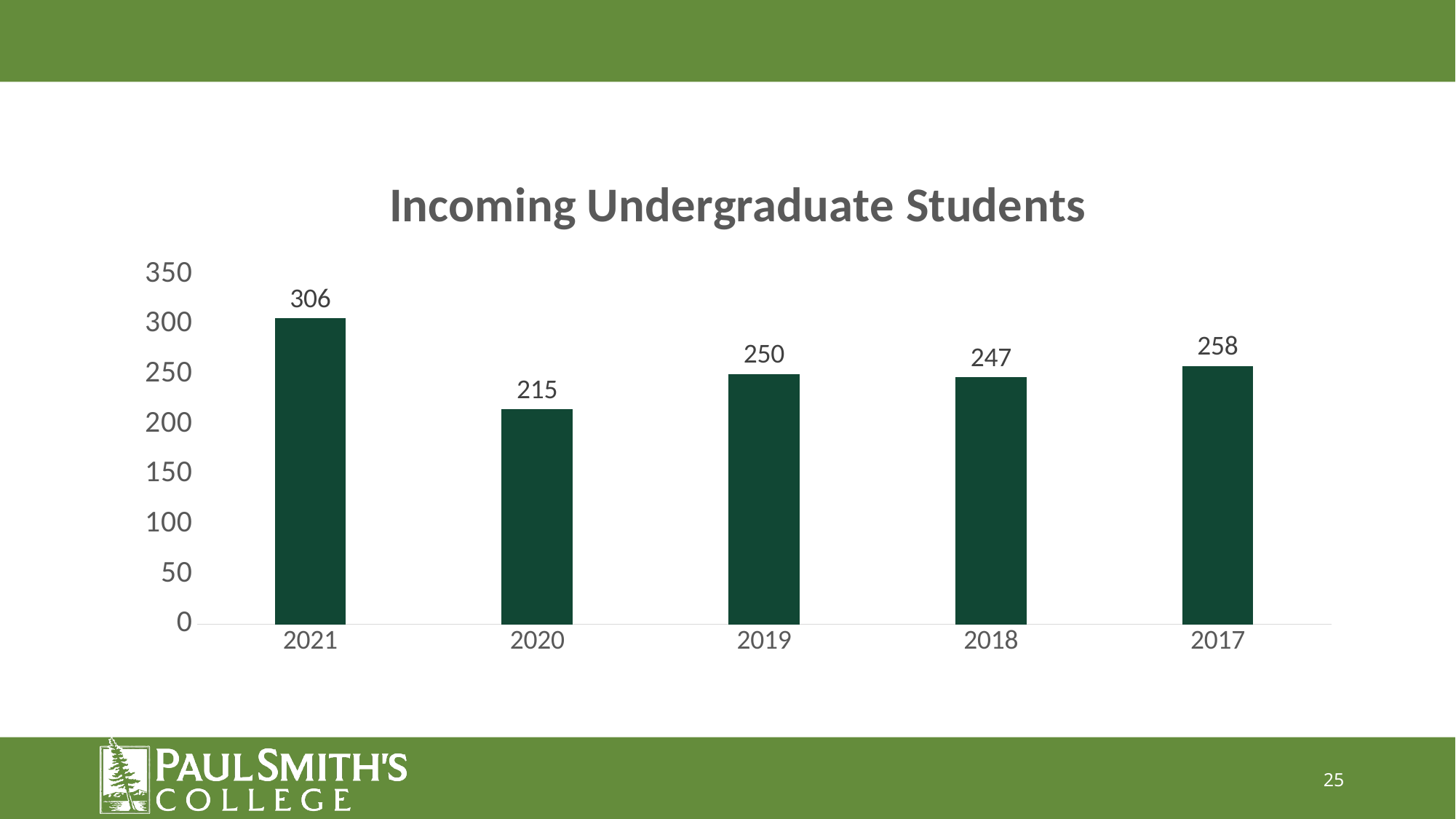
What is the number of incoming undergraduate students for 2021? 306 What is the difference between the values for 2021 and 2020? 91 What is the number of incoming undergraduate students for 2017? 258 How many years are shown on the x axis? 5 What is the difference between the values for 2017 and 2018? 11 What kind of chart is shown on the slide? bar chart What is the number of incoming undergraduate students for 2020? 215 Is the value for 2018 greater or less than 200? greater Which is larger, the value for 2019 or the value for 2020? 2019 Which year has the highest number of incoming undergraduate students? 2021 Which year has the lowest number of incoming undergraduate students? 2020 What is the title of the chart? Incoming Undergraduate Students